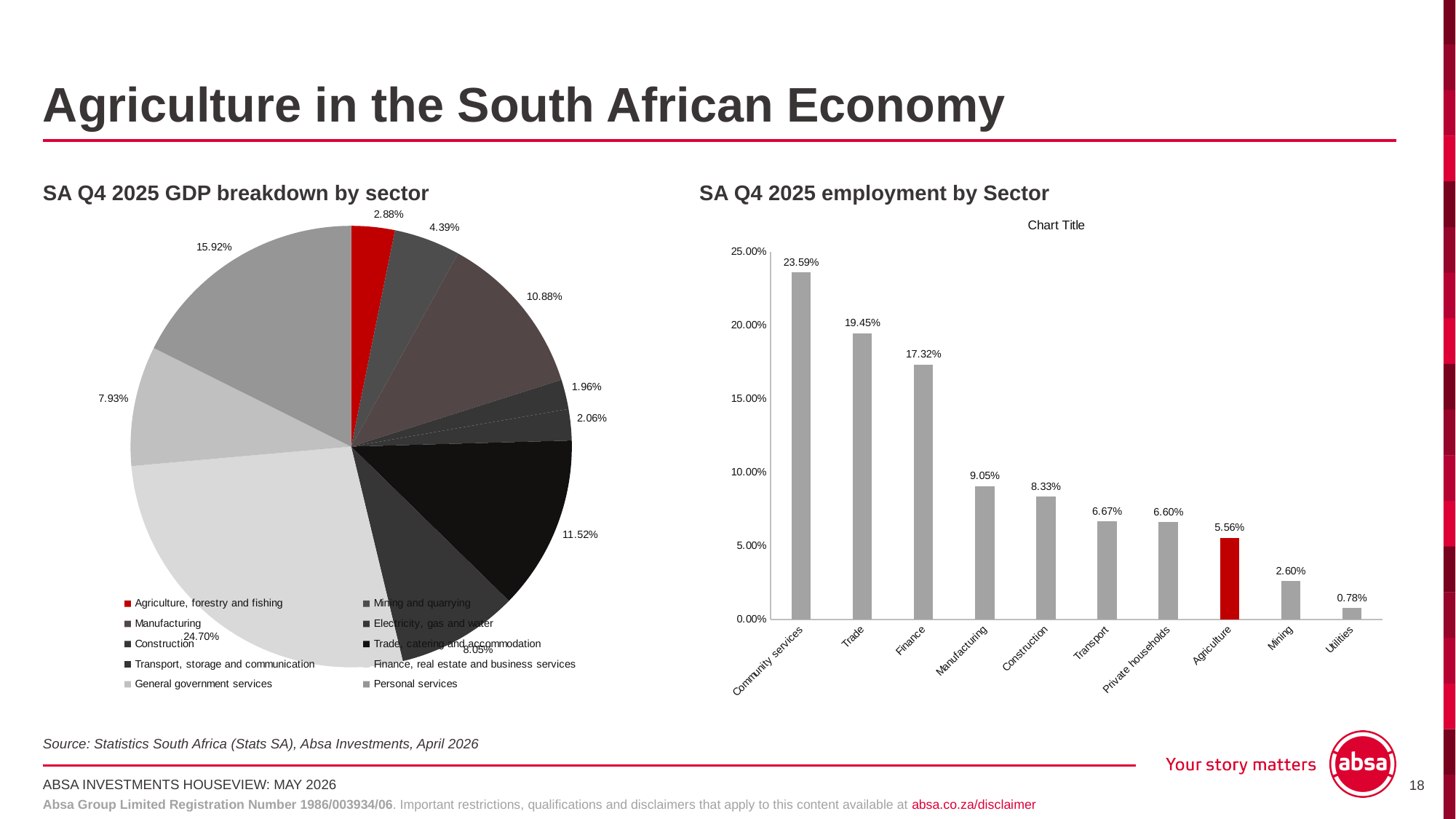
In the SA Q4 2025 employment by Sector chart, how many sectors are shown? 10 In the SA Q4 2025 GDP breakdown by sector pie chart, what is the share for Agriculture, forestry and fishing? 2.88% In the SA Q4 2025 employment by Sector chart, which is larger, Manufacturing or Construction? Manufacturing In the SA Q4 2025 employment by Sector chart, what is the value for Agriculture? 5.56% What kind of chart is the SA Q4 2025 GDP breakdown by sector chart? pie chart In the SA Q4 2025 employment by Sector chart, what is the difference between Trade and Finance? 2.13% In the SA Q4 2025 GDP breakdown by sector pie chart, what is the share for Manufacturing? 10.88% In the SA Q4 2025 employment by Sector chart, what is the value for Community services? 23.59% In the SA Q4 2025 employment by Sector chart, which sector has the highest value? Community services In the SA Q4 2025 employment by Sector chart, do the values rise or fall from left to right? fall In the SA Q4 2025 employment by Sector chart, which sector has the lowest value? Utilities In the SA Q4 2025 GDP breakdown by sector pie chart, what is the value of the largest slice? 24.70%